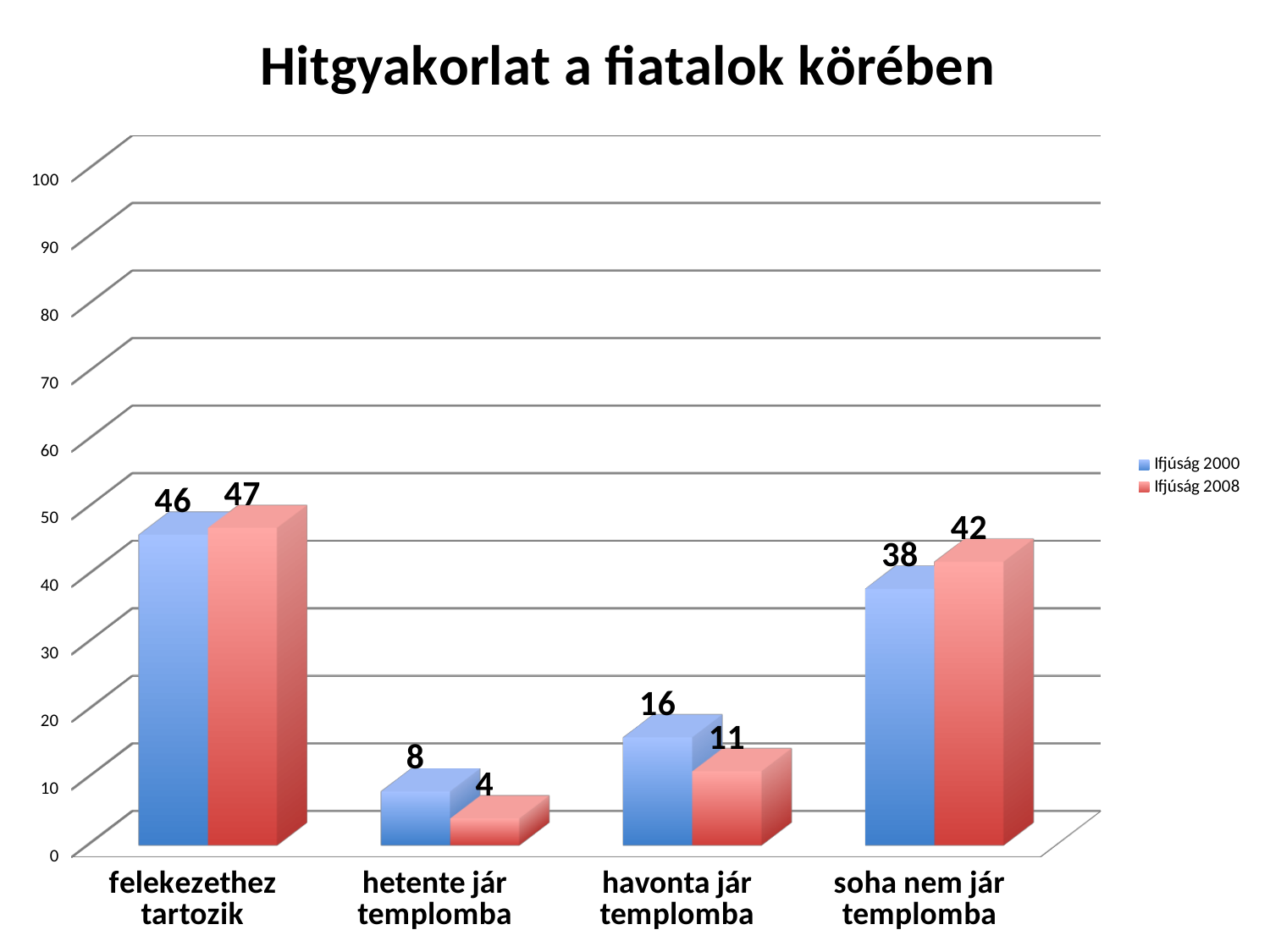
What is the difference between the Ifjúság 2000 and Ifjúság 2008 values for "havonta jár templomba"? 5 What is the value for "hetente jár templomba" in the Ifjúság 2008 series? 4 Which category has the lowest value in the Ifjúság 2008 series? hetente jár templomba How many series does the legend list? 2 Which series has the larger value for "hetente jár templomba", Ifjúság 2000 or Ifjúság 2008? Ifjúság 2000 Which category has the highest value in the Ifjúság 2000 series? felekezethez tartozik What is the title of the chart? Hitgyakorlat a fiatalok körében What is the value for "felekezethez tartozik" in the Ifjúság 2000 series? 46 What is the value for "soha nem jár templomba" in the Ifjúság 2008 series? 42 How many categories are shown on the x axis? 4 What is the difference between the Ifjúság 2008 and Ifjúság 2000 values for "soha nem jár templomba"? 4 Is the value for "soha nem jár templomba" in the Ifjúság 2000 series greater or less than 30? greater